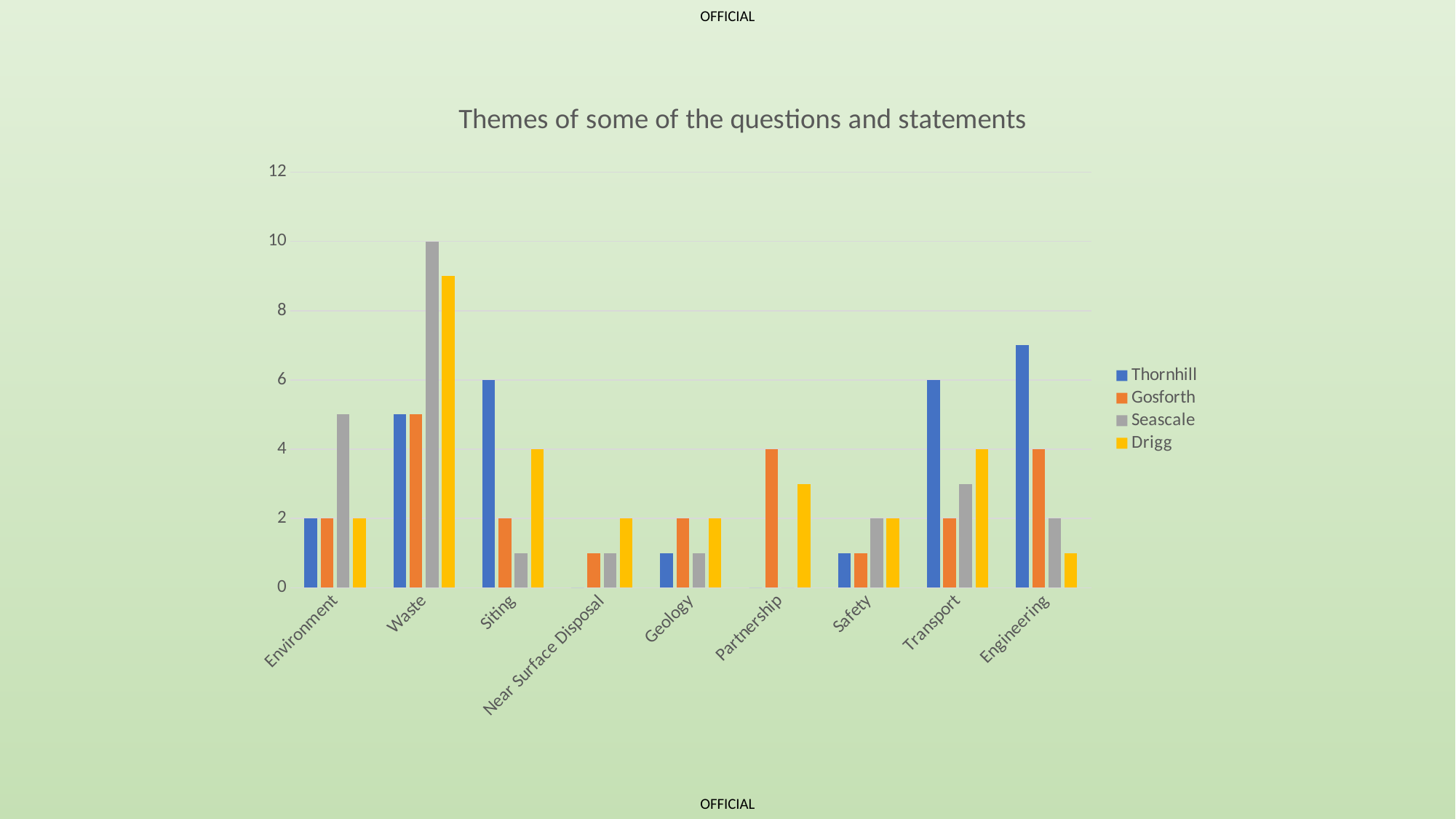
Which is larger: Thornhill in Transport or Seascale in Transport? Thornhill in Transport What kind of chart is shown on the slide? bar chart What is the value for Seascale in the Waste category? 10 Is the value for Thornhill in the Engineering category greater or less than 6? greater What is the value for Thornhill in the Siting category? 6 How many theme categories are shown on the x axis? 9 Which series has the highest value in the Engineering category? Thornhill What is the value for Gosforth in the Partnership category? 4 Which series has the highest value in the Environment category? Seascale How many series does the legend list? 4 Is the value for Drigg in the Waste category greater or less than 8? greater What is the difference between Seascale in Waste and Thornhill in Siting? 4